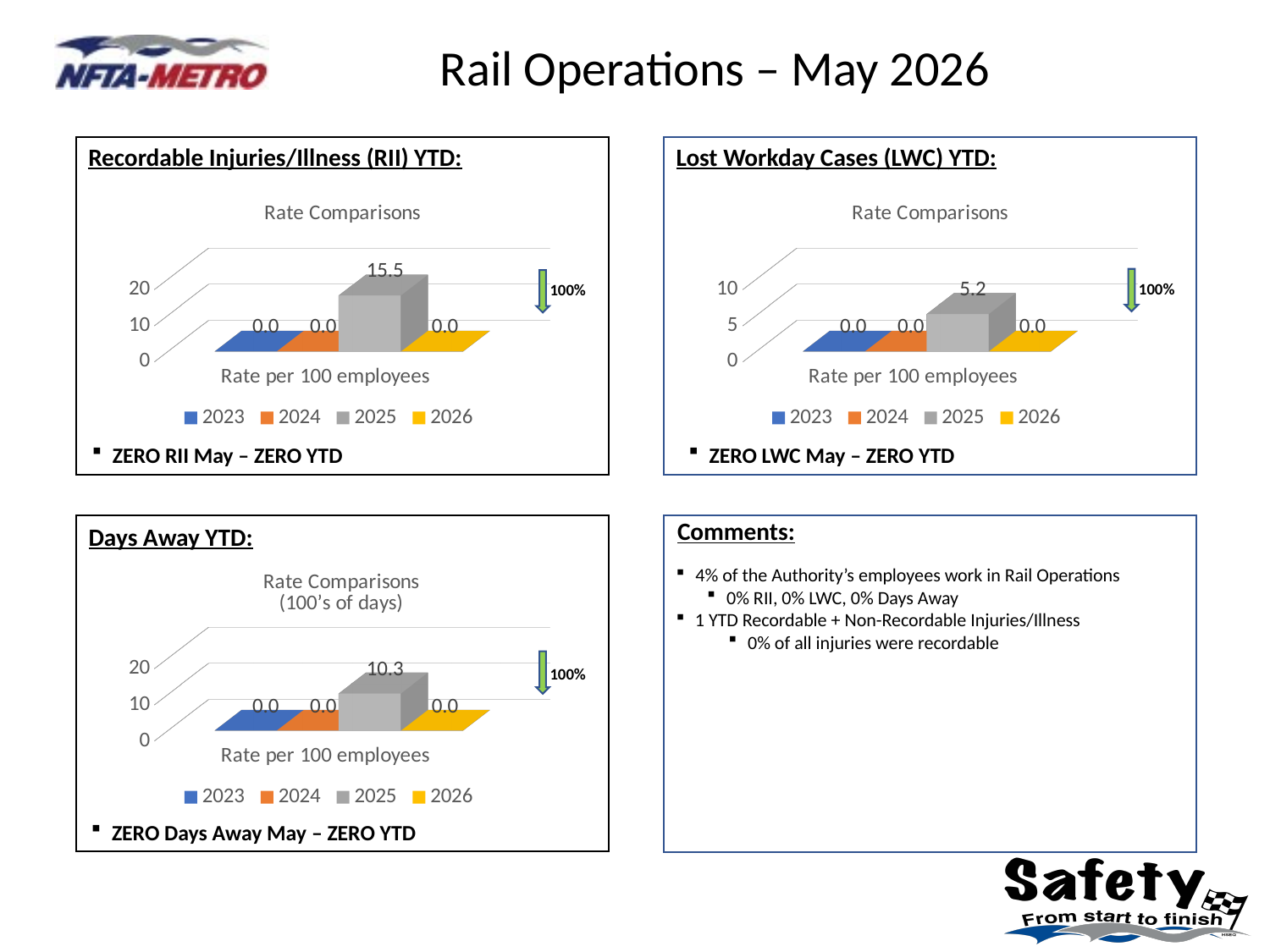
How many series does the legend of the Recordable Injuries/Illness (RII) YTD chart list? 4 In the Recordable Injuries/Illness (RII) YTD chart, what is the value for 2026? 0.0 In the Days Away YTD chart, which year has the highest value? 2025 In the Lost Workday Cases (LWC) YTD chart, is the value for 2025 greater or less than 5? greater In the Days Away YTD chart, is the value for 2025 greater or less than 20? less In the Days Away YTD chart, what is the value for 2025? 10.3 In the Recordable Injuries/Illness (RII) YTD chart, what is the difference between the 2025 value and the 2026 value? 15.5 In the Lost Workday Cases (LWC) YTD chart, which year has the highest value? 2025 What is the title of the chart in the Lost Workday Cases (LWC) YTD box? Rate Comparisons In the Recordable Injuries/Illness (RII) YTD chart, what is the value for 2025? 15.5 What kind of chart is the Days Away YTD chart? Bar chart In the Lost Workday Cases (LWC) YTD chart, what is the value for 2025? 5.2